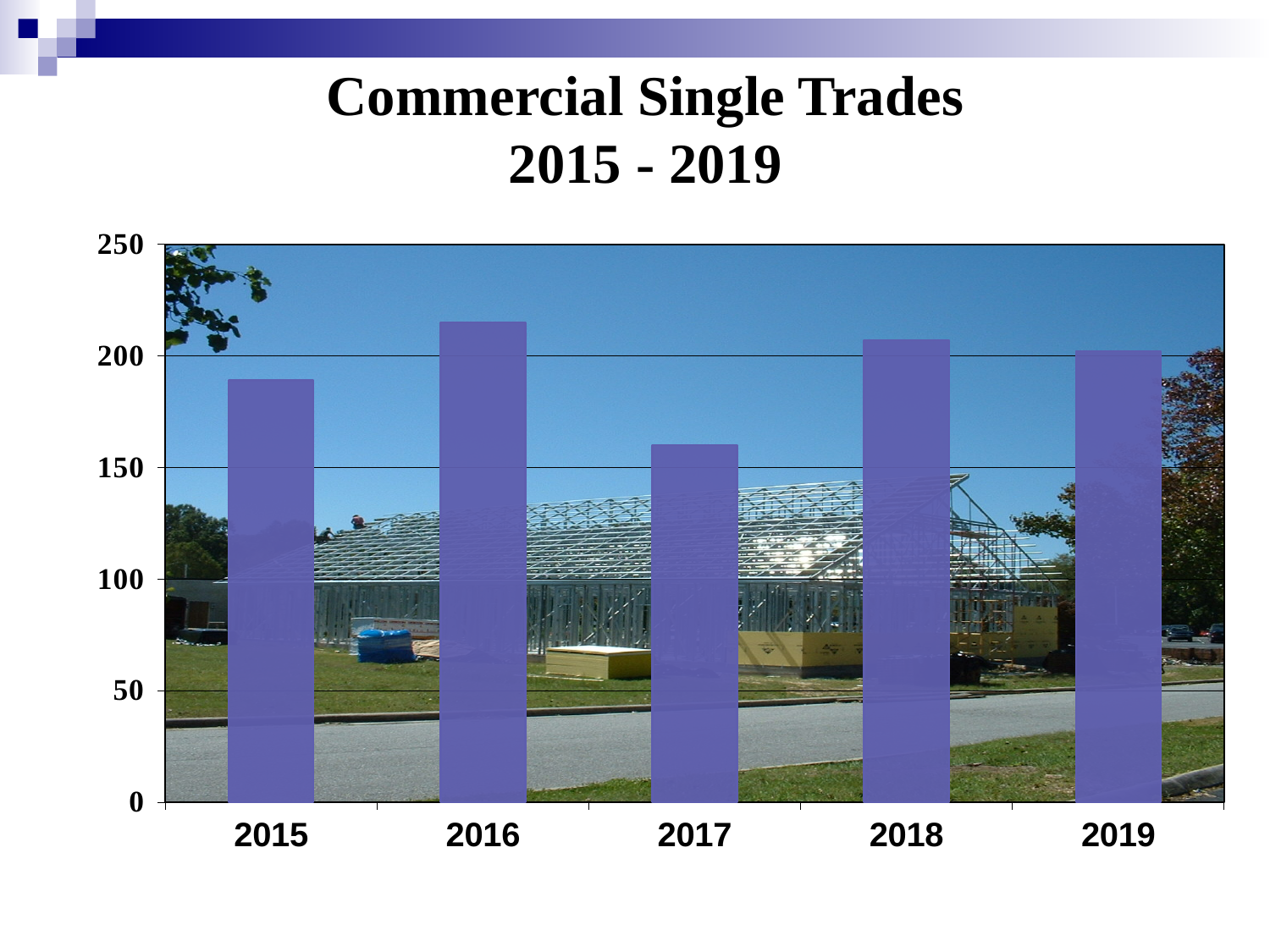
Which year has the larger value, 2016 or 2017? 2016 Did the value rise or fall from 2016 to 2017? fall Is the value for 2016 greater or less than 200? greater How many years (bars) are shown in the chart? 5 Is the value for 2017 greater or less than 200? less Which year has the highest value? 2016 Which year has the lowest value? 2017 Is the value for 2015 greater or less than 200? less Which year has the larger value, 2015 or 2017? 2015 What type of chart is shown on the slide? bar chart What is the title of the chart? Commercial Single Trades 2015 - 2019